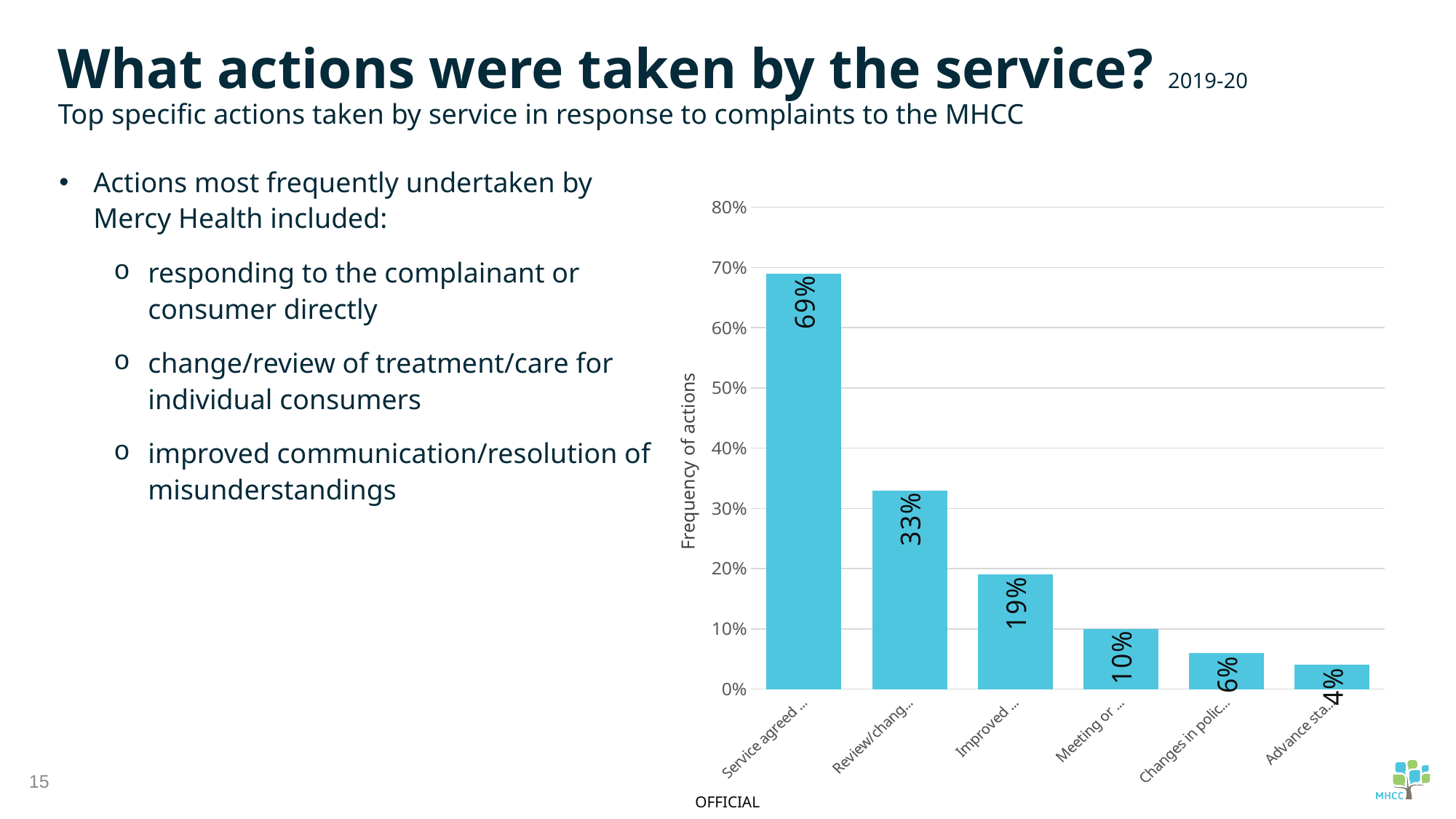
What is the value of the bar labelled "Review/chang..."? 33% What is the value of the bar labelled "Meeting or ..."? 10% How many bars are shown in the chart? 6 Is the value for the bar labelled "Improved ..." greater or less than 20%? less What type of chart is shown on the slide? bar chart Which bar has the lowest value? Advance sta... What is the value of the last bar, labelled "Advance sta..."? 4% What is the value of the first bar, labelled "Service agreed ..."? 69% What is the difference between the first bar (69%) and the second bar (33%)? 36% Which bar has the highest value? Service agreed ... Which is larger: the bar labelled "Improved ..." or the bar labelled "Changes in polic..."? Improved ... What is the label of the vertical axis? Frequency of actions